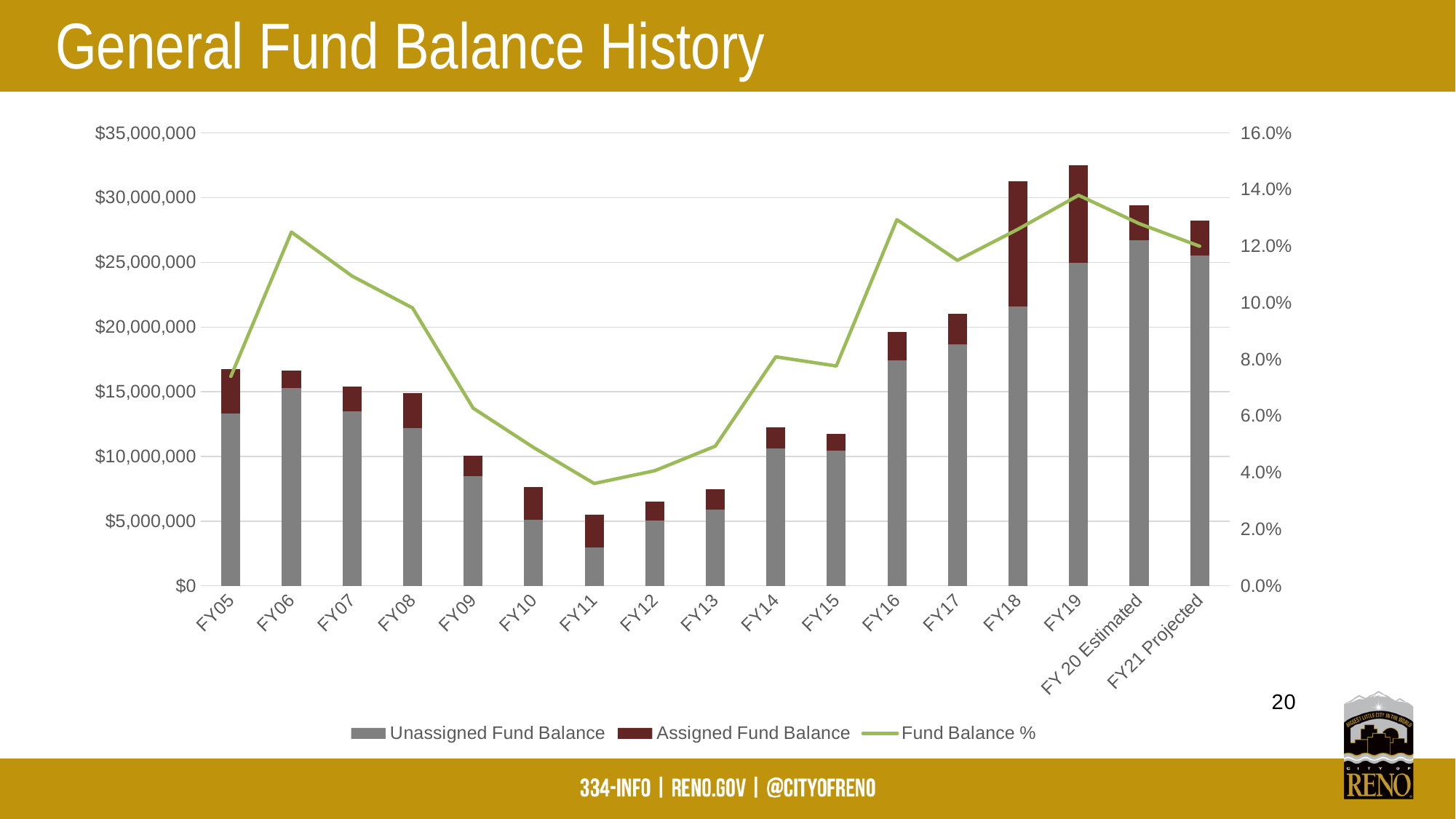
Is the total fund balance for FY11 greater or less than $10,000,000? less Does the total fund balance rise or fall from FY05 to FY11? fall In which fiscal year does the Fund Balance % line reach its highest point? FY19 How many fiscal-year categories are shown on the x axis? 17 Is the total fund balance for FY19 greater or less than $30,000,000? greater Which fiscal year has the lowest total fund balance (stacked bar)? FY11 In which fiscal year does the Fund Balance % line reach its lowest point? FY11 Which has the larger total fund balance, FY09 or FY10? FY09 How many series does the legend list? 3 What kind of chart is shown on the slide? A bar chart with a line Is the Fund Balance % for FY16 greater or less than 12.0%? greater Which fiscal year has the highest total fund balance (stacked bar)? FY19